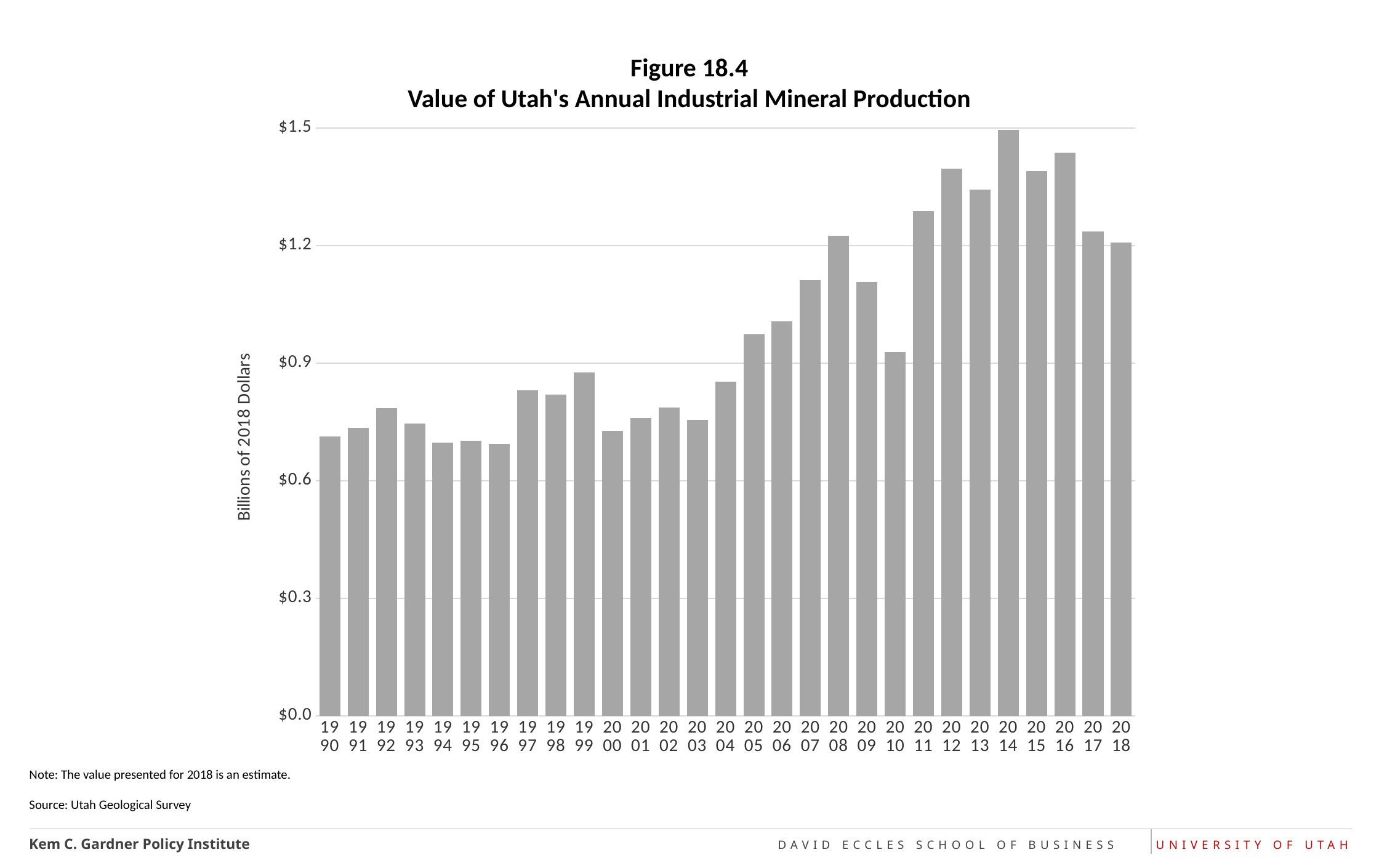
Is the value for 2016 greater or less than $1.5? less Which year has the highest value of industrial mineral production? 2014 Is the value for 2011 greater or less than $1.2? greater Which year has the larger value, 2009 or 2010? 2009 Is the value for 1990 greater or less than $0.6? greater What kind of chart is shown on the slide? bar chart How many years are plotted on the x axis? 29 What is the label on the vertical axis? Billions of 2018 Dollars Overall, do the values rise or fall from 1990 to 2014? rise Which year has the larger value, 2008 or 2009? 2008